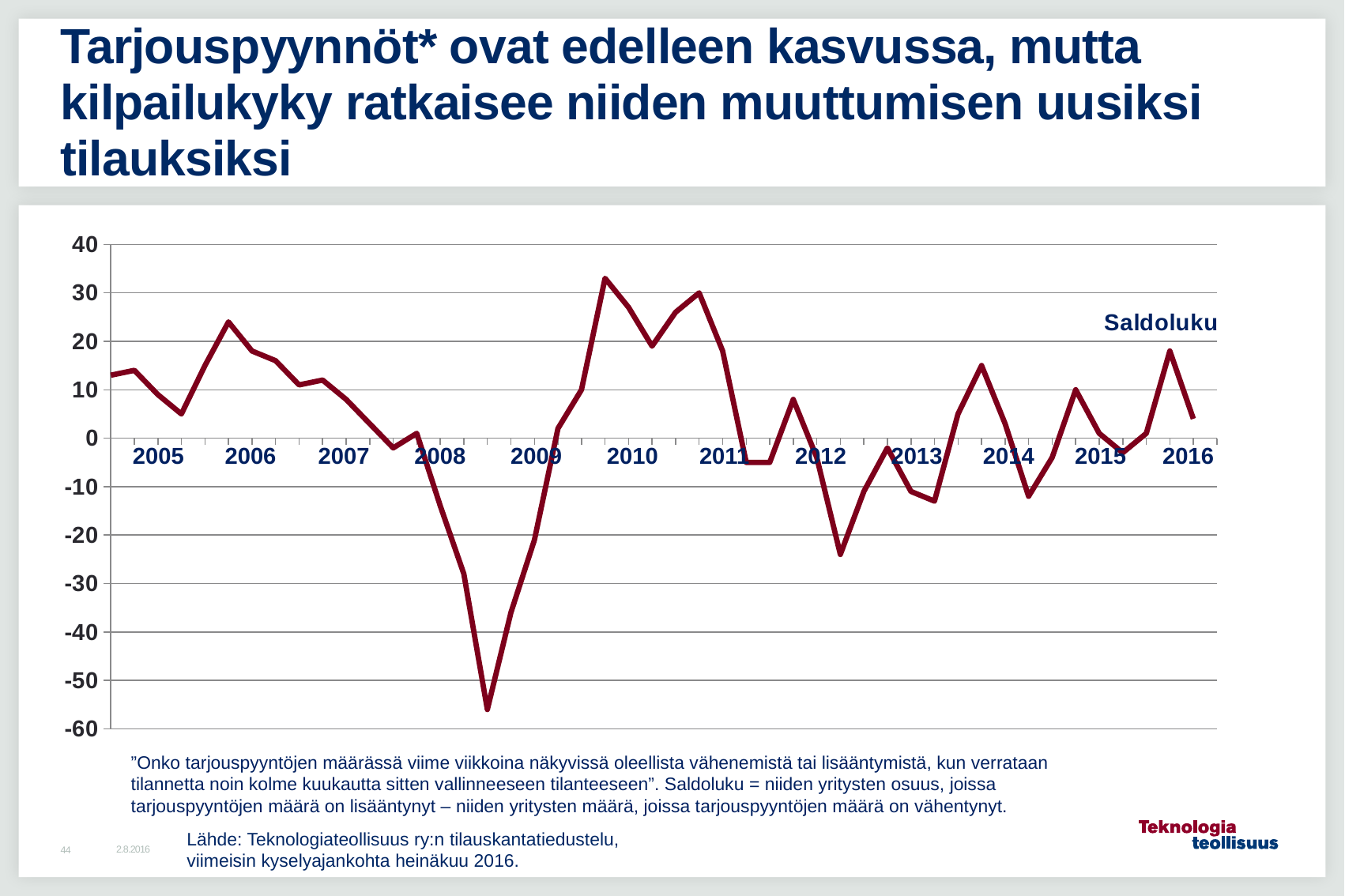
Is the lowest point of the line greater or less than -50? less Is the value at the start of the series in 2005 greater or less than 10? greater Is the highest point of the line greater or less than 30? greater Is the value at 2005 higher or lower than the value at 2016? higher Which is higher: the peak of the line near 2006 or the peak near 2010? the peak near 2010 What kind of chart is shown on the slide? line chart Does the line rise or fall between the 2009 and 2010 labels? rise What is the highest value shown on the y axis of the chart? 40 How many years are labelled on the x axis of the chart? 12 Does the line rise or fall between the 2007 and 2008 labels? fall What is the name of the series plotted on the chart? Saldoluku